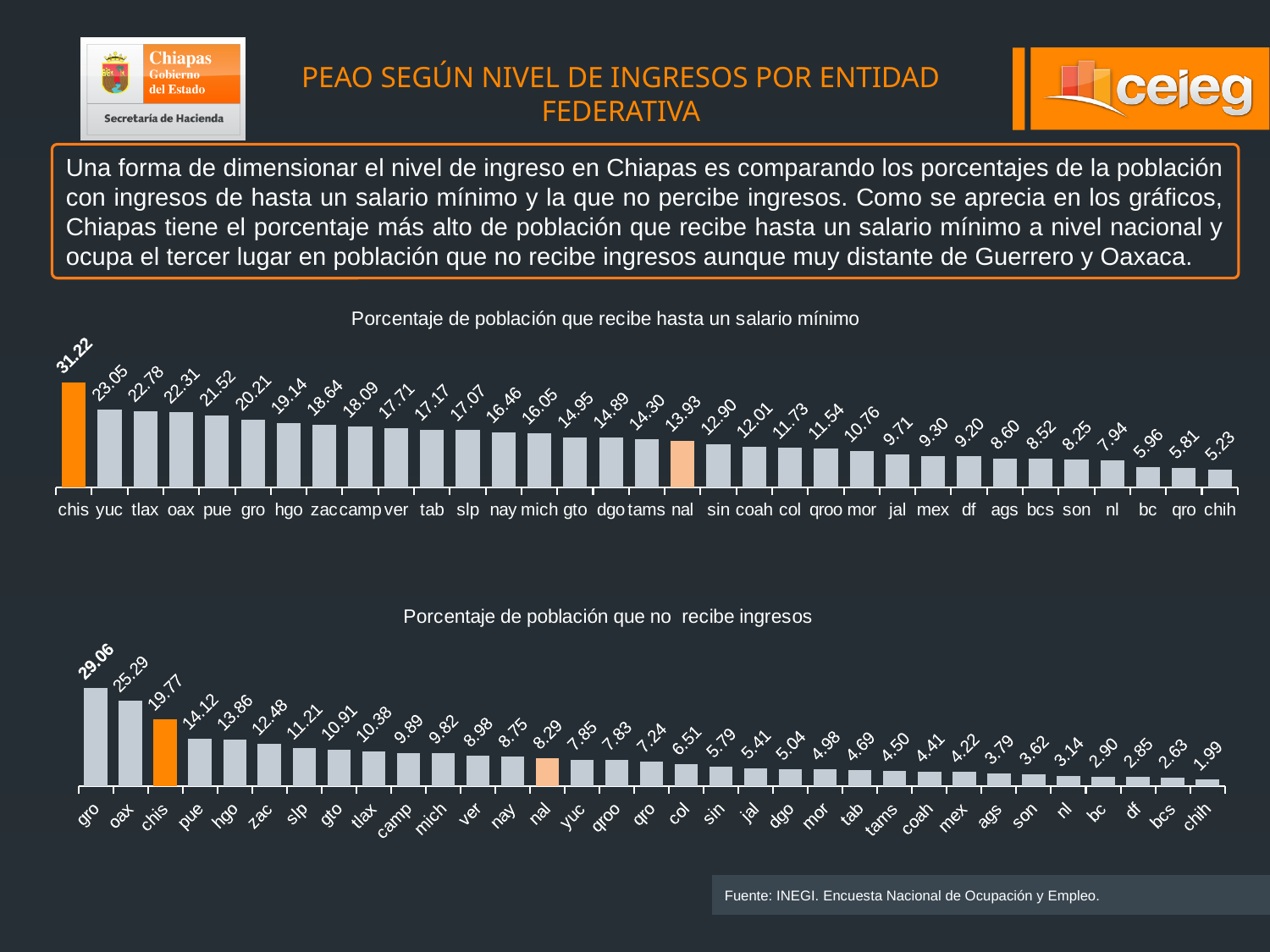
In the chart 'Porcentaje de población que no recibe ingresos', which category has the highest value? gro In the chart 'Porcentaje de población que recibe hasta un salario mínimo', which category has the lowest value? chih What kind of chart is 'Porcentaje de población que no recibe ingresos'? bar chart In the chart 'Porcentaje de población que no recibe ingresos', what is the difference between the values for gro and oax? 3.77 In the chart 'Porcentaje de población que recibe hasta un salario mínimo', how many bars are plotted? 33 In the chart 'Porcentaje de población que no recibe ingresos', what is the value for chis? 19.77 In the chart 'Porcentaje de población que recibe hasta un salario mínimo', what is the value for chis? 31.22 In the chart 'Porcentaje de población que recibe hasta un salario mínimo', what is the difference between the values for chis and yuc? 8.17 In the chart 'Porcentaje de población que recibe hasta un salario mínimo', do the values rise or fall from left to right along the x axis? fall In the chart 'Porcentaje de población que no recibe ingresos', which is larger, the value for oax or the value for chis? oax In the chart 'Porcentaje de población que no recibe ingresos', what is the value for gro? 29.06 In the chart 'Porcentaje de población que recibe hasta un salario mínimo', what is the value for nal? 13.93